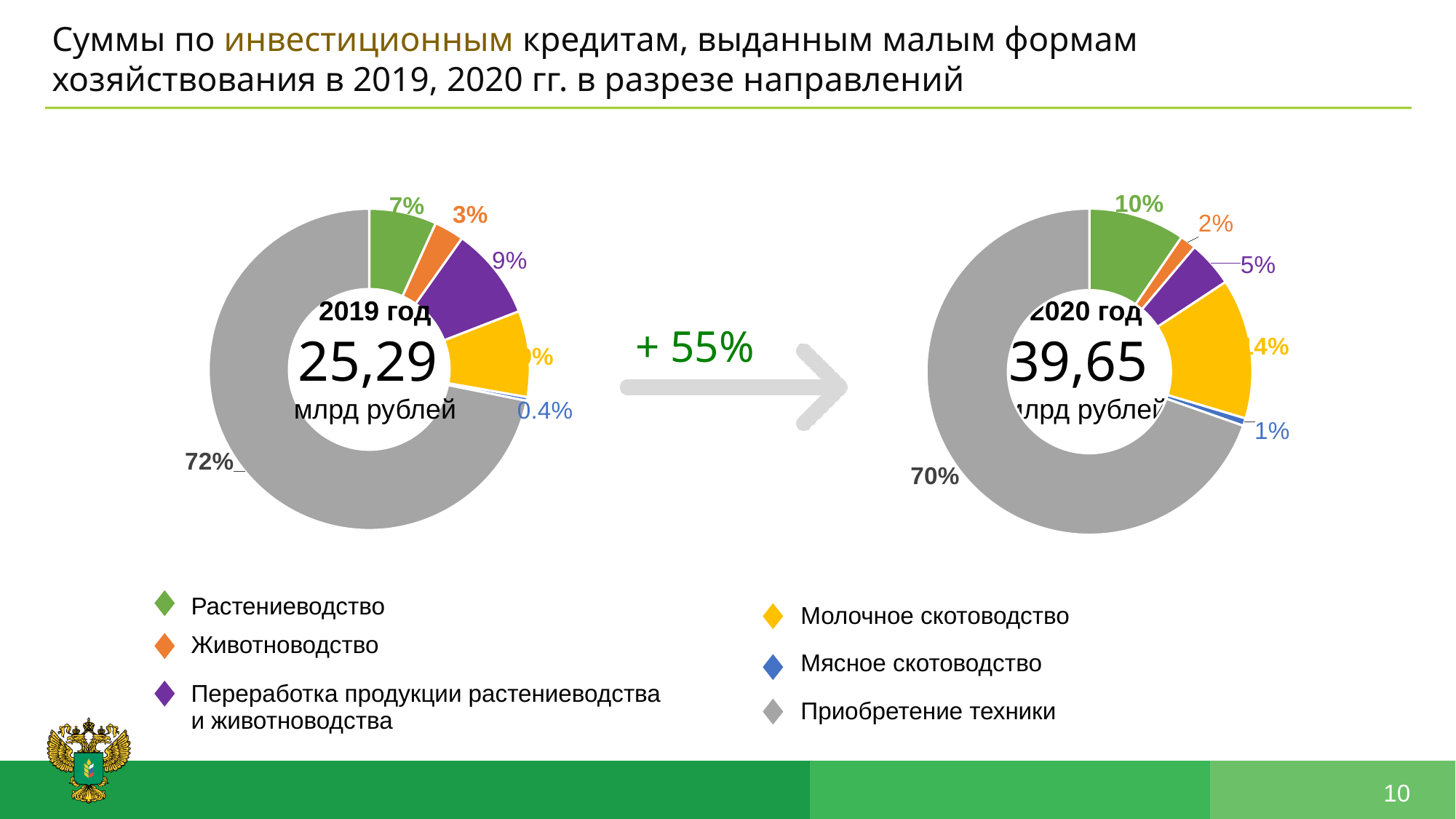
In the 2019 год chart, what share does Приобретение техники have? 72% In the 2019 год chart, which category has the largest share? Приобретение техники In the 2019 год chart, what share does Мясное скотоводство have? 0.4% In the 2019 год chart, which is larger: the share of Животноводство or the share of Переработка продукции растениеводства и животноводства? Переработка продукции растениеводства и животноводства What kind of charts are shown on the slide? Pie (donut) charts In the 2020 год chart, what share does Переработка продукции растениеводства и животноводства have? 5% How many categories does the legend list? 6 In the 2019 год chart, what share does Растениеводство have? 7% In the 2020 год chart, what share does Растениеводство have? 10% In the 2020 год chart, what share does Приобретение техники have? 70% In the 2020 год chart, which category has the smallest share? Мясное скотоводство What is the total amount shown in the centre of the 2020 год chart? 39,65 млрд рублей